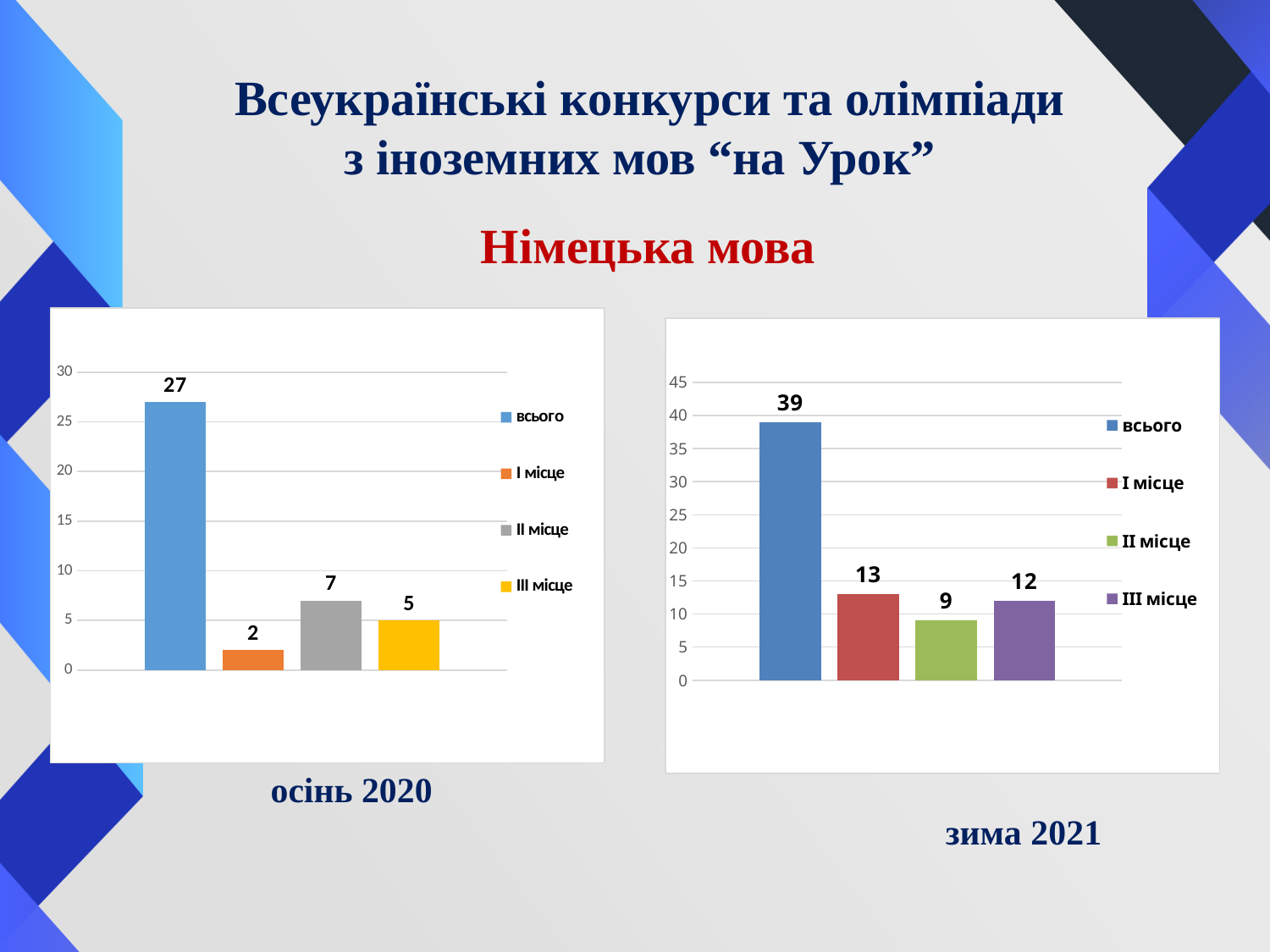
How many series does the legend of the right chart (зима 2021) list? 4 What kind of chart is the left chart (осінь 2020)? bar chart In the right chart (зима 2021), what colour is the bar for всього? blue In the right chart (зима 2021), what is the value for II місце? 9 In the right chart (зима 2021), what is the value for всього? 39 In the left chart (осінь 2020), what is the value for I місце? 2 In the right chart (зима 2021), what is the difference between I місце and III місце? 1 In the left chart (осінь 2020), what is the value for всього? 27 In the right chart (зима 2021), which category has the highest value? всього In the left chart (осінь 2020), which is larger: II місце or III місце? II місце In the left chart (осінь 2020), which category has the lowest value? I місце In the left chart (осінь 2020), what is the difference between всього and II місце? 20